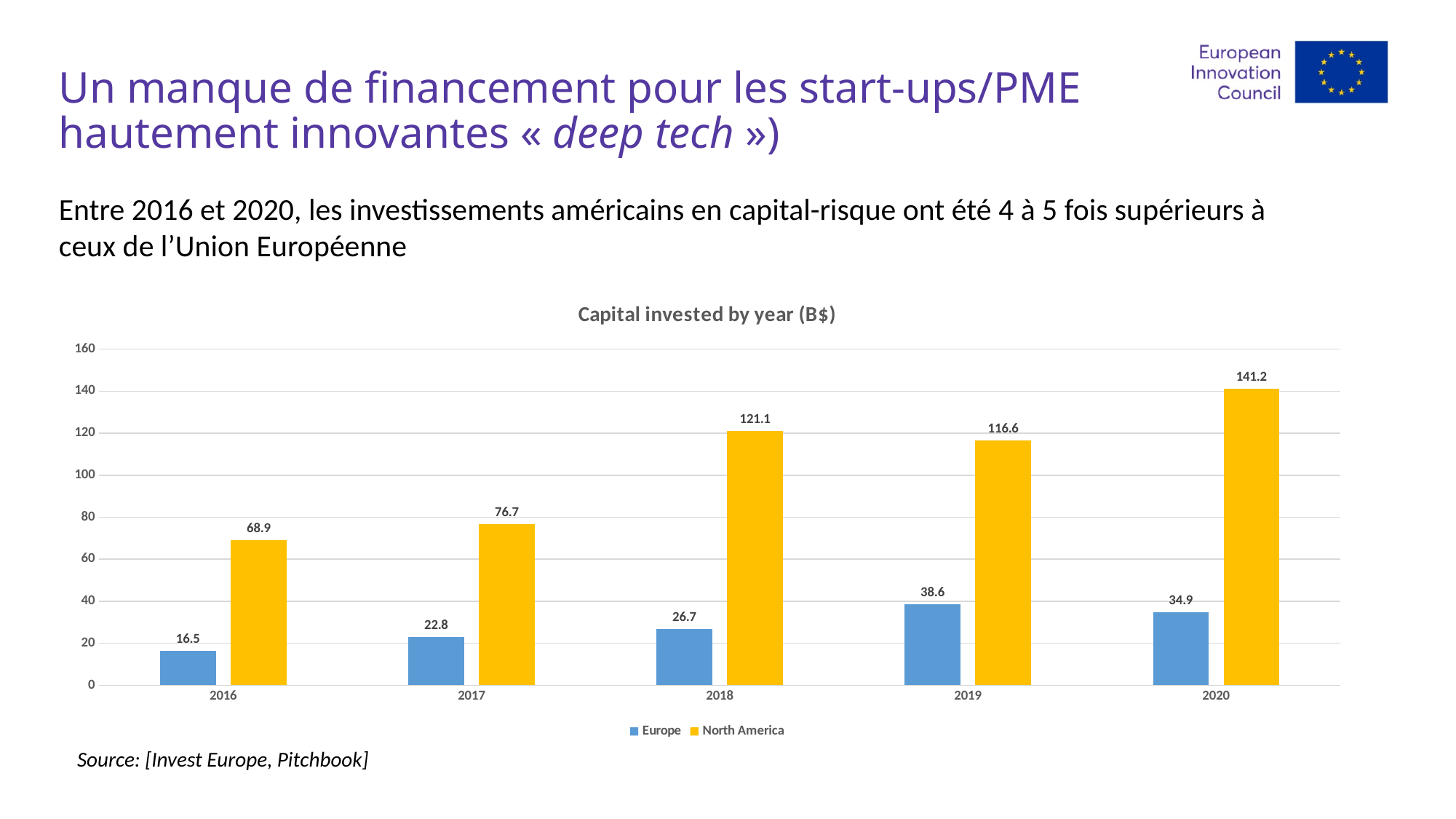
What is the value for Europe in 2019? 38.6 How many series does the legend list? 2 In which year is the Europe value lowest? 2016 Which is larger in 2019: Europe or North America? North America What kind of chart is shown? bar chart How many years are shown on the x axis? 5 What is the value for North America in 2020? 141.2 What is the title of the chart? Capital invested by year (B$) What is the value for Europe in 2016? 16.5 In which year is the North America value highest? 2020 What is the difference between North America and Europe in 2018? 94.4 Is the value for North America in 2017 greater or less than 80? less